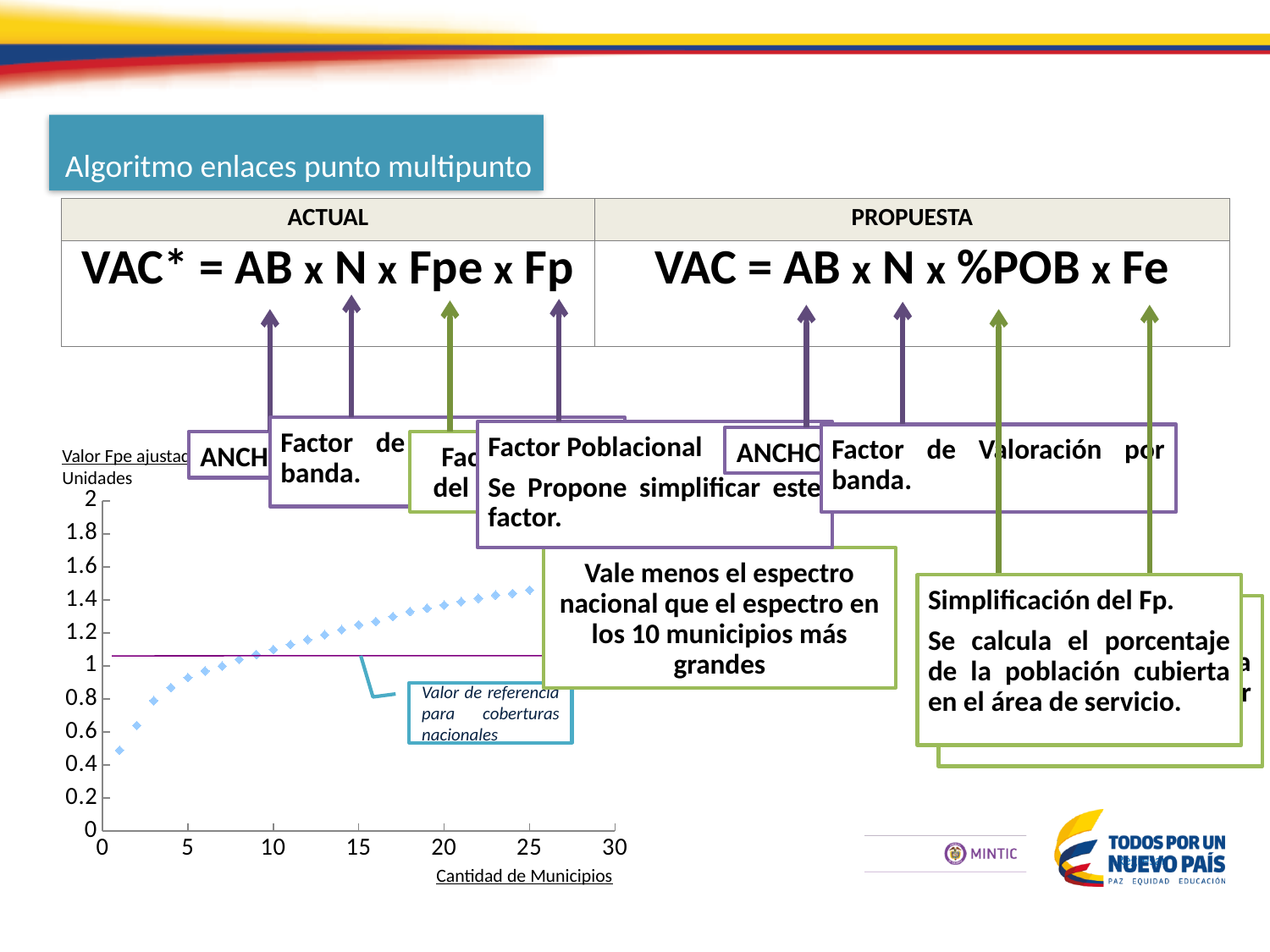
Is the plotted value at 5 municipalities greater or less than 1? less Do the plotted values rise or fall as the number of municipalities (Cantidad de Municipios) increases? rise What kind of chart is shown on the slide? scatter chart Is the plotted value at 1 municipality greater or less than 0.8? less Is the plotted value at 15 municipalities greater or less than 1? greater What is the label of the x axis of the chart? Cantidad de Municipios What is the highest tick value shown on the y axis of the chart? 2